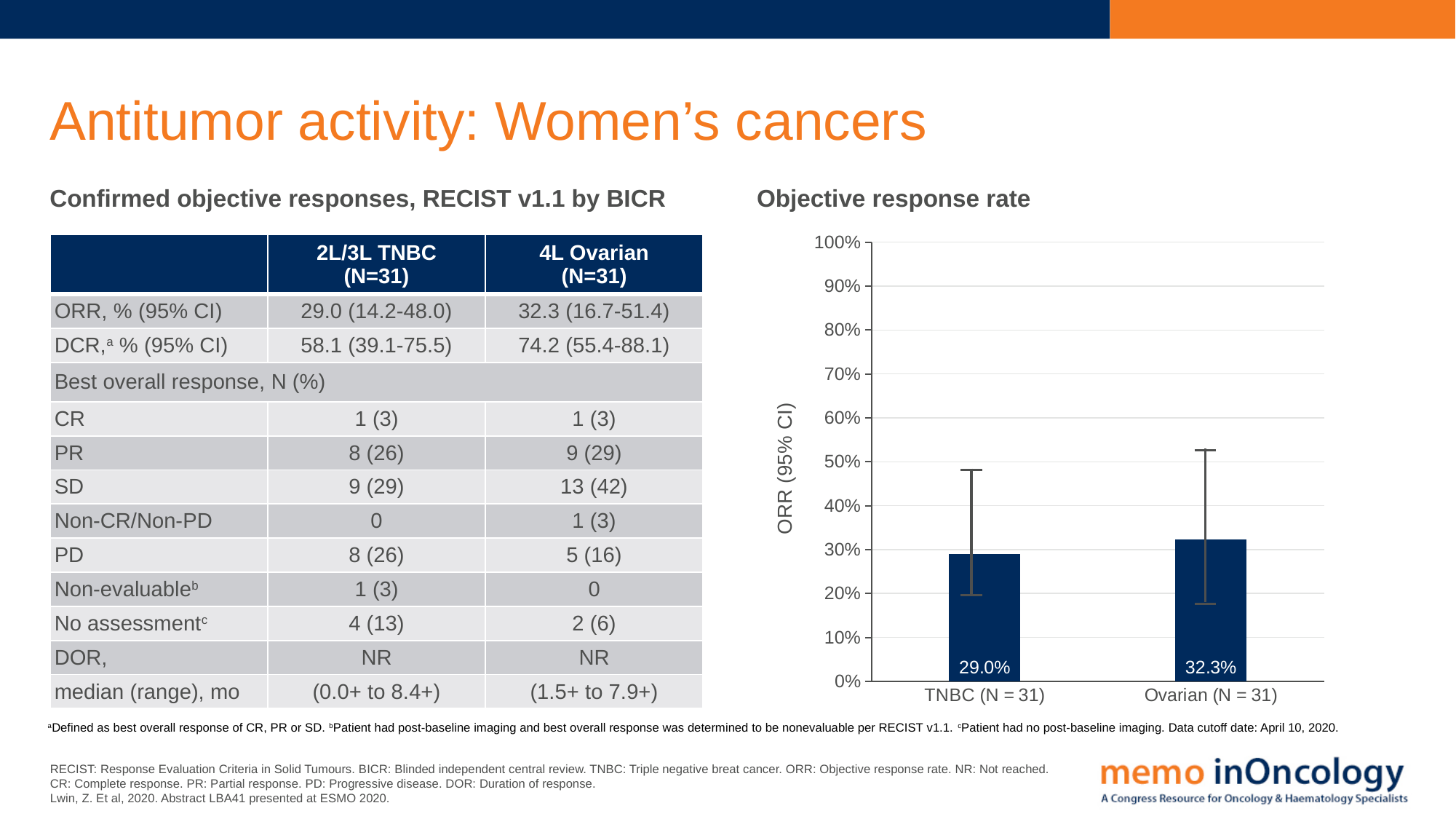
Which category has the lower ORR in the Objective response rate chart? TNBC (N = 31) What is the title of the chart on the slide? Objective response rate What is the maximum value shown on the y-axis of the Objective response rate chart? 100% What is the difference between the Ovarian and TNBC ORR values in the Objective response rate chart? 3.3% Which category has the higher ORR in the Objective response rate chart? Ovarian (N = 31) How many categories are plotted in the Objective response rate chart? 2 What is the ORR value shown for Ovarian (N = 31) in the Objective response rate chart? 32.3% What is the ORR value shown for TNBC (N = 31) in the Objective response rate chart? 29.0% Is the ORR for Ovarian (N = 31) greater or less than 30%? greater Is the ORR for TNBC (N = 31) greater or less than 30%? less What is the y-axis label of the Objective response rate chart? ORR (95% CI) What kind of chart is the Objective response rate chart? bar chart